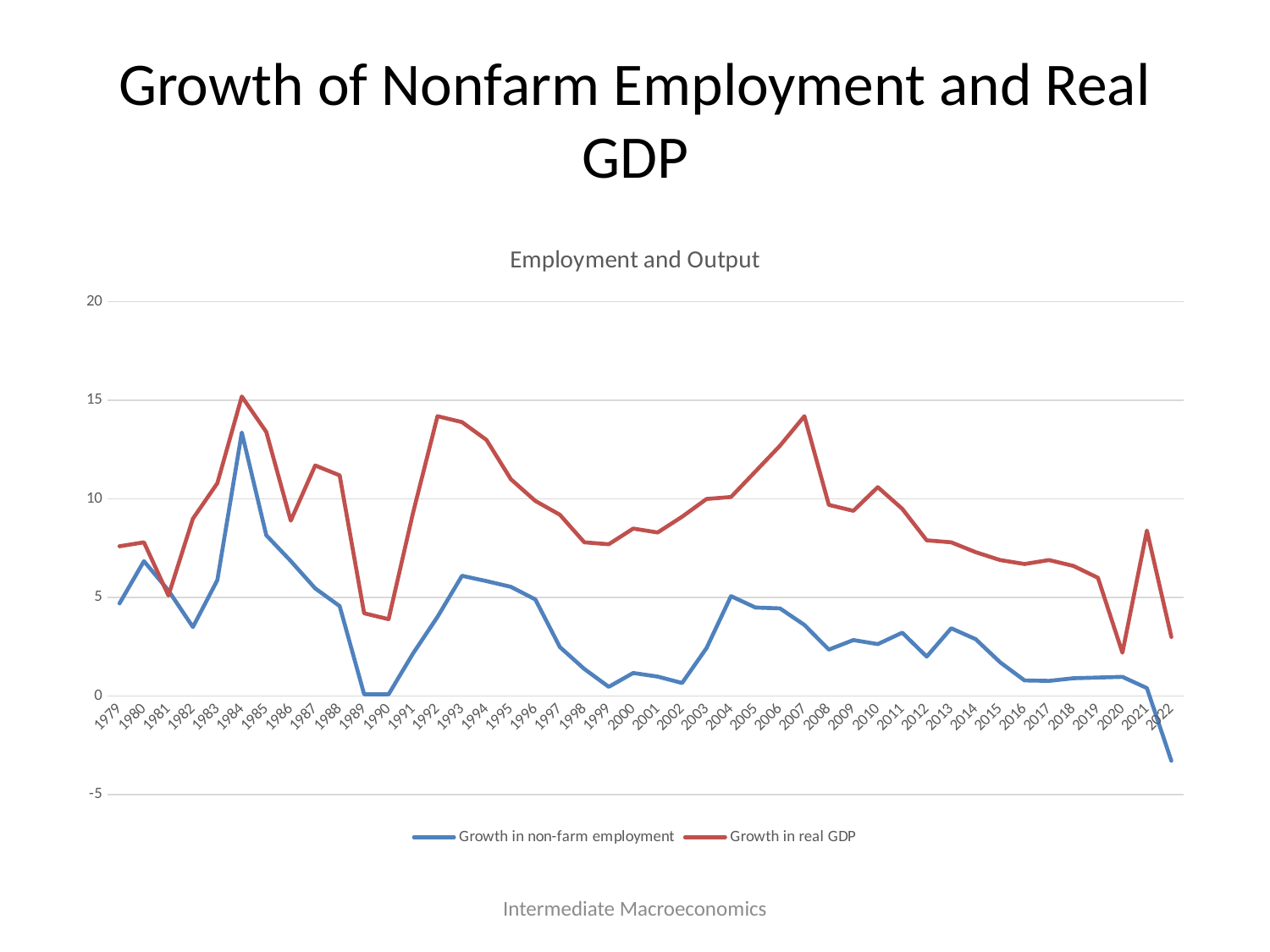
In which year does growth in non-farm employment reach its lowest value? 2022 What is the title shown above the chart area? Employment and Output Is the value for growth in non-farm employment in 2022 greater or less than 0? less How many years are plotted along the x axis? 44 How many series does the legend list? 2 In which year does growth in real GDP reach its highest value? 1984 Is the value for growth in non-farm employment in 1989 greater or less than 5? less What kind of chart is shown on the slide? line chart Which series is higher in 2020, growth in non-farm employment or growth in real GDP? Growth in real GDP Does growth in non-farm employment rise or fall between 2021 and 2022? fall Is the value for growth in real GDP in 2007 greater or less than 10? greater